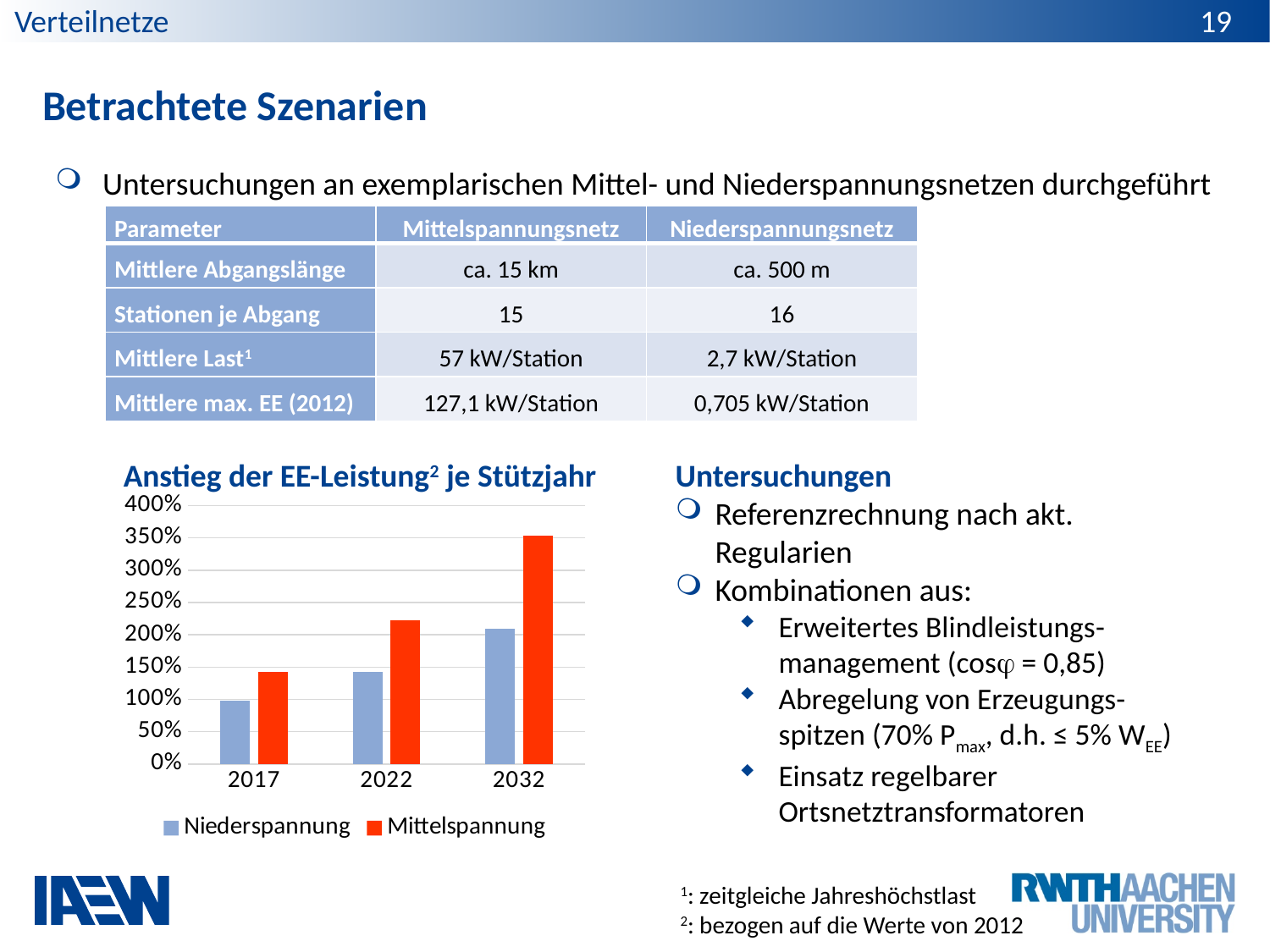
Is the value for Mittelspannung in 2022 greater or less than 200%? greater Is the value for Niederspannung in 2017 greater or less than 150%? less How many series does the legend of the chart list? 2 In 2032, which series has the larger value, Niederspannung or Mittelspannung? Mittelspannung In which year is the Niederspannung bar lowest? 2017 Do the Mittelspannung values rise or fall from 2017 to 2032? rise Is the value for Mittelspannung in 2032 greater or less than 300%? greater In which year is the Mittelspannung bar highest? 2032 Which series in the chart is shown in red? Mittelspannung What type of chart is shown under the title 'Anstieg der EE-Leistung je Stützjahr'? bar chart How many years (categories) are shown on the x axis of the chart? 3